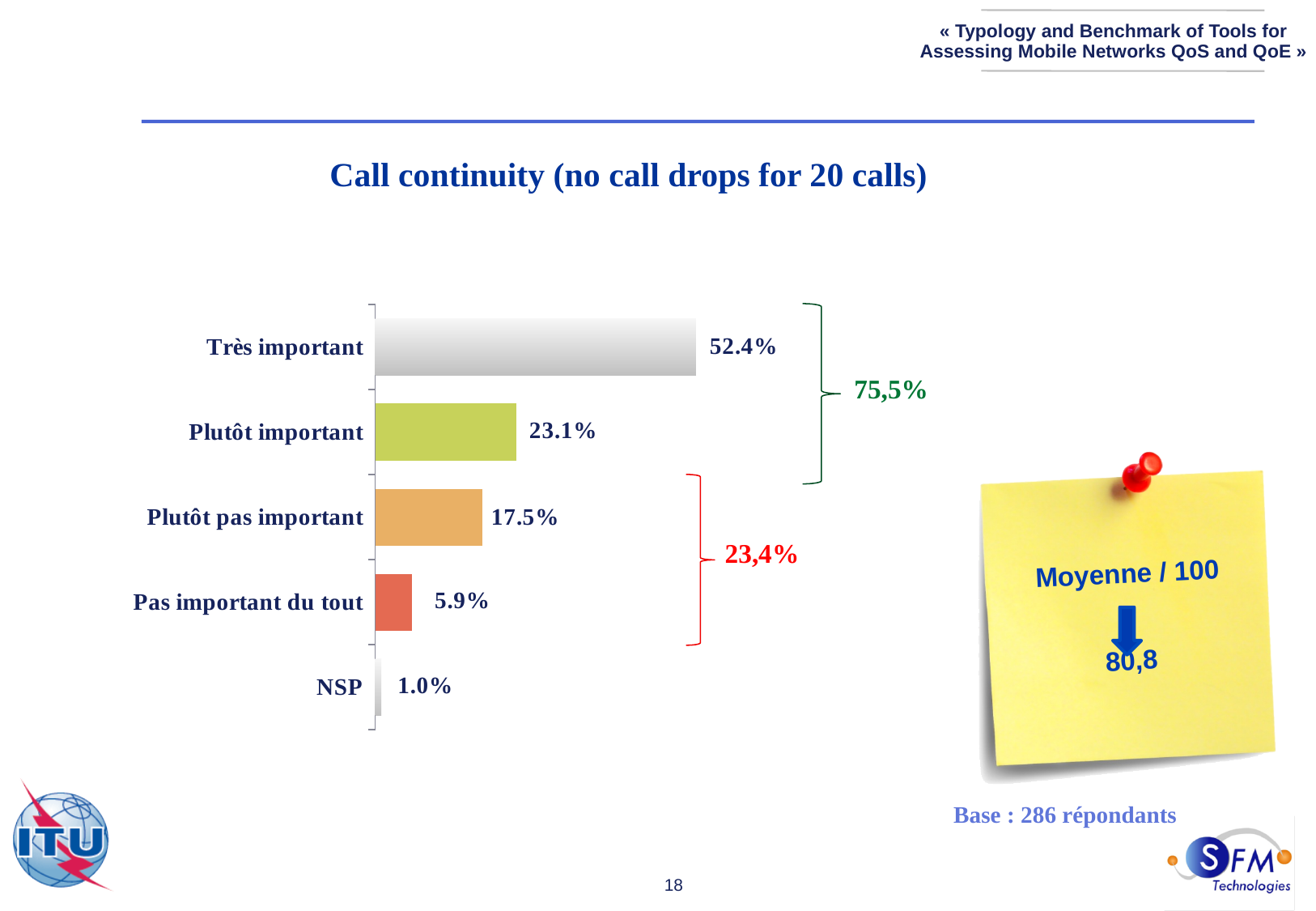
What is the value for "NSP"? 1.0% What is the title of the chart? Call continuity (no call drops for 20 calls) What combined percentage is shown by the red bracket grouping "Plutôt pas important" and "Pas important du tout"? 23,4% Which category has the lowest value? NSP What is the value for "Plutôt pas important"? 17.5% Which is larger, the value for "Plutôt pas important" or the value for "Pas important du tout"? Plutôt pas important Which category has the highest value? Très important What combined percentage is shown by the green bracket grouping "Très important" and "Plutôt important"? 75,5% What is the difference between the values for "Très important" and "Plutôt important"? 29.3% What kind of chart is shown on the slide? Bar chart What is the value for "Très important"? 52.4% How many categories are shown in the chart? 5